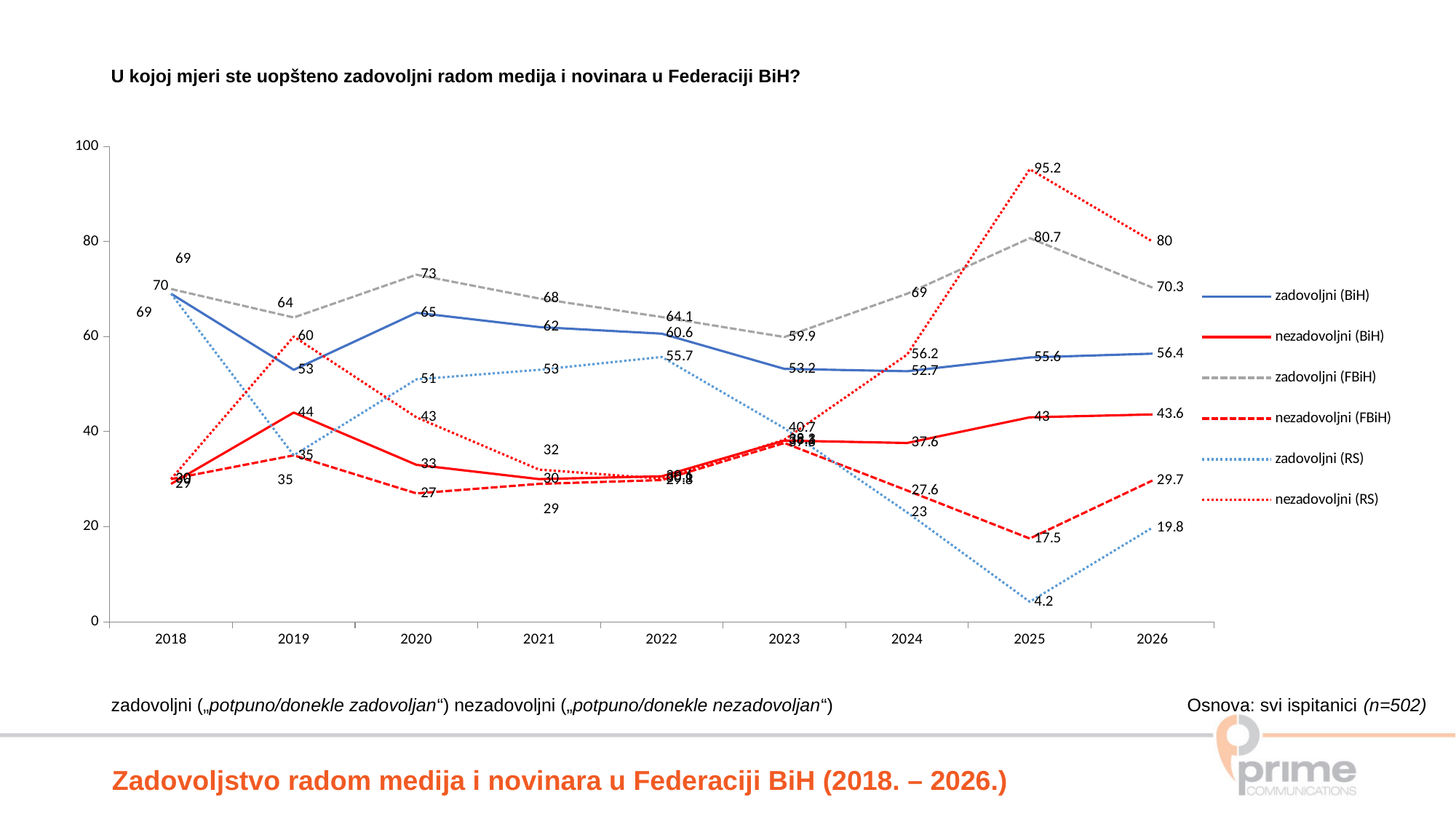
How many series does the legend list? 6 What is the value for nezadovoljni (RS) in 2025? 95.2 What kind of chart is shown on the slide? line chart What is the value for zadovoljni (RS) in 2025? 4.2 What is the value for nezadovoljni (FBiH) in 2025? 17.5 In which year does nezadovoljni (RS) reach its highest value? 2025 What is the value for zadovoljni (FBiH) in 2020? 73 What is the value for zadovoljni (BiH) in 2026? 56.4 In 2025, which is larger: zadovoljni (FBiH) or nezadovoljni (RS)? nezadovoljni (RS) What is the difference between zadovoljni (BiH) and nezadovoljni (BiH) in 2026? 12.8 In which year does zadovoljni (RS) reach its lowest value? 2025 How many years are shown on the x axis? 9